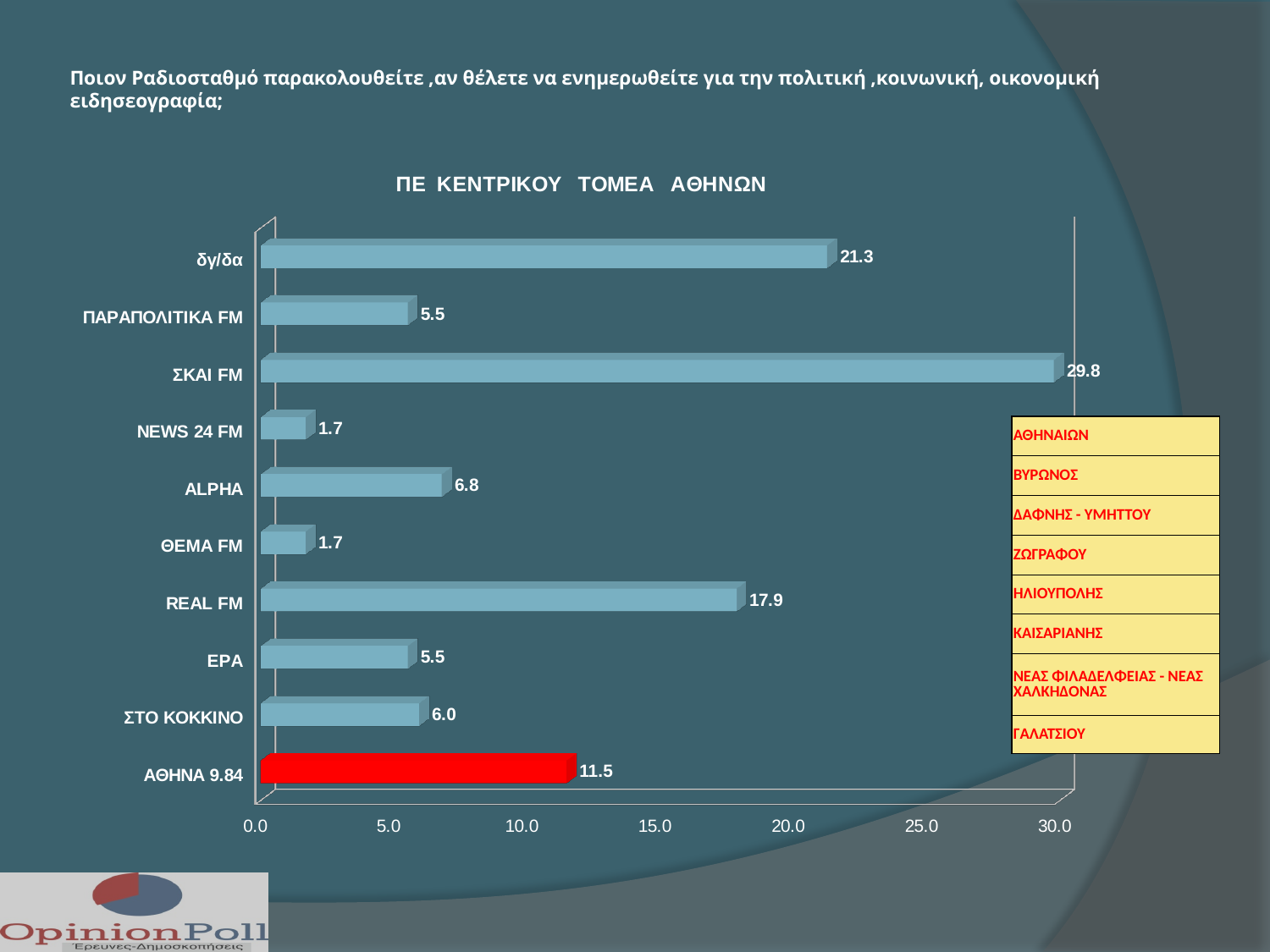
What is the value for ΑΘΗΝΑ 9.84? 11.5 What is the value for δγ/δα? 21.3 What kind of chart is shown on the slide? bar chart What is the value for REAL FM? 17.9 Which category's bar is coloured red? ΑΘΗΝΑ 9.84 How many categories are shown on the chart? 10 What is the value for ΣΚΑΙ FM? 29.8 What is the difference between the values for ΣΚΑΙ FM and δγ/δα? 8.5 Is the value for REAL FM greater or less than 15.0? greater Which is larger, the value for ALPHA or the value for ΣΤΟ ΚΟΚΚΙΝΟ? ALPHA Which category has the highest value? ΣΚΑΙ FM What is the title of the chart? ΠΕ ΚΕΝΤΡΙΚΟΥ ΤΟΜΕΑ ΑΘΗΝΩΝ